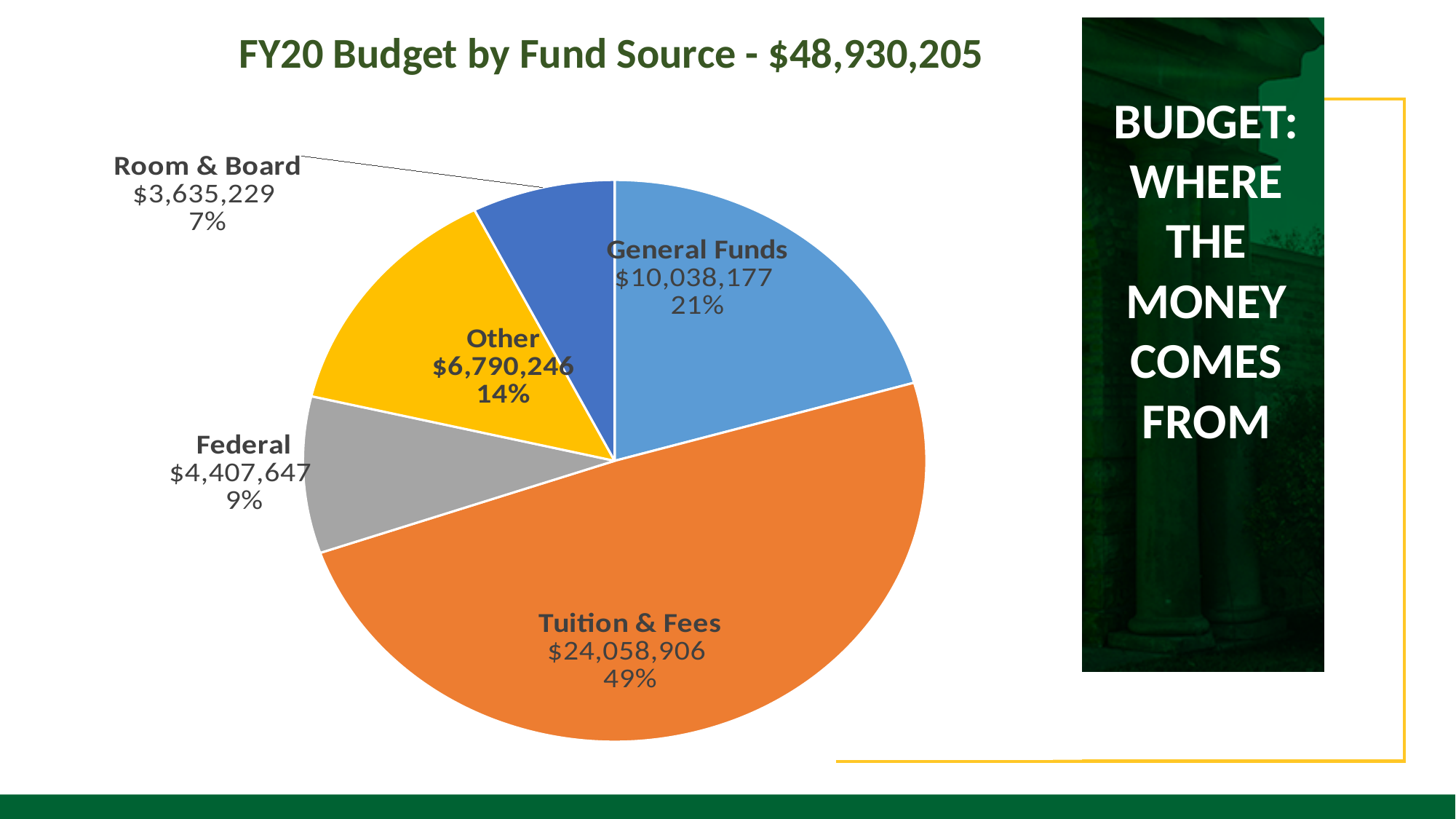
What is the dollar value for Room & Board? $3,635,229 Which is larger, Other or Federal? Other How many fund sources (slices) does the pie chart show? 5 Which fund source is the smallest? Room & Board What share of the budget comes from Other? 14% What is the dollar value for Tuition & Fees? $24,058,906 What is the difference in dollars between Tuition & Fees and General Funds? $14,020,729 What kind of chart is shown on the slide? Pie chart Which fund source is the largest? Tuition & Fees What is the dollar value for General Funds? $10,038,177 What share of the budget comes from Federal? 9% What is the title of the chart? FY20 Budget by Fund Source - $48,930,205